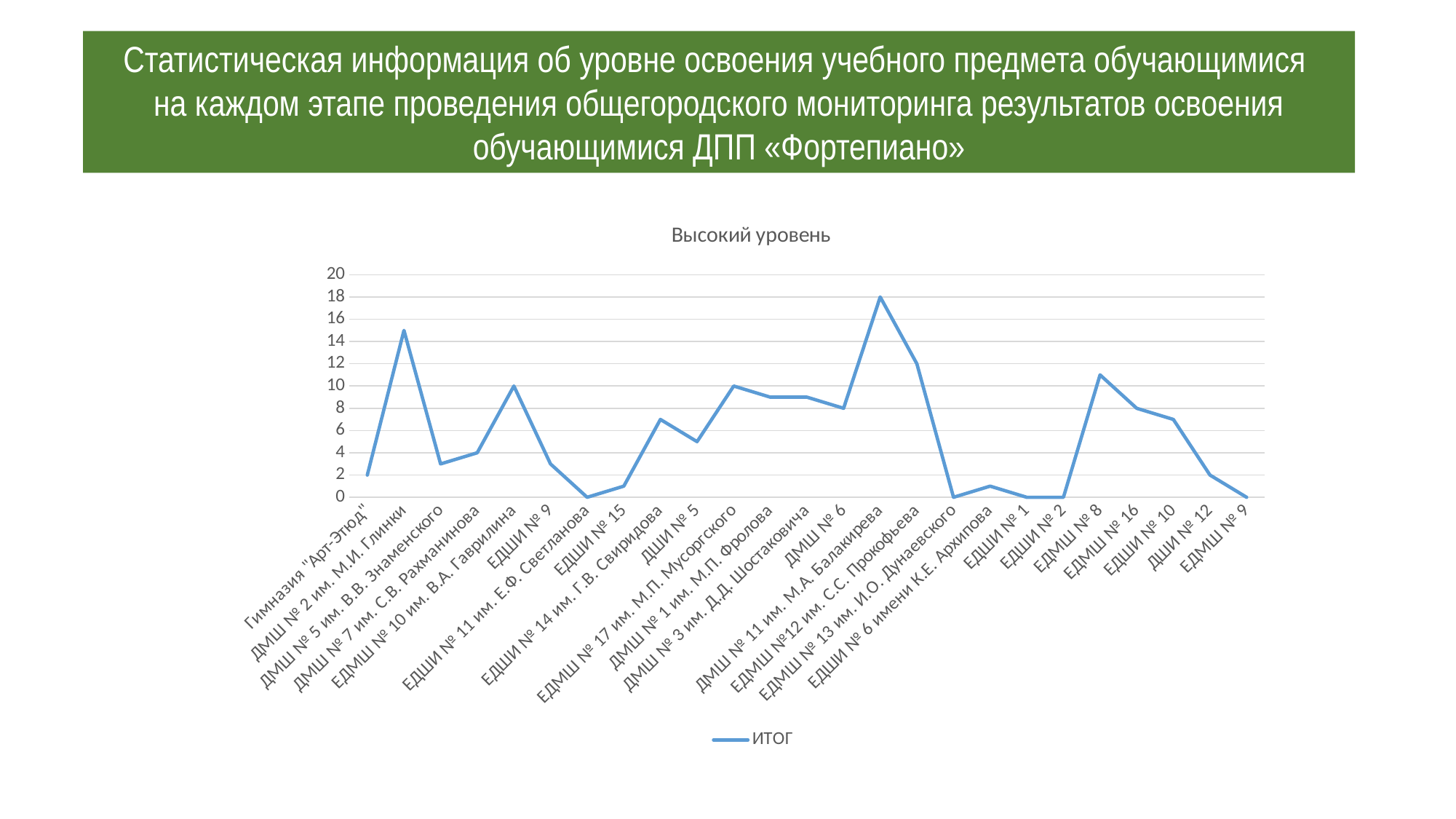
What is the title of the chart? Высокий уровень What type of chart is shown on the slide? line chart How many series does the legend list? 1 What is the value for ЕДМШ № 10 им. В.А. Гаврилина? 10 How many schools (categories) are plotted on the x axis? 25 Which is larger, the value for ЕДМШ № 8 or the value for ДШИ № 12? ЕДМШ № 8 What is the name of the series shown in the legend? ИТОГ Which school has the highest value? ДМШ № 11 им. М.А. Балакирева Is the value for ДМШ № 2 им. М.И. Глинки greater or less than 10? greater Is the value for ДМШ № 5 им. В.В. Знаменского greater or less than 6? less What is the value for ЕДМШ №12 им. С.С. Прокофьева? 12